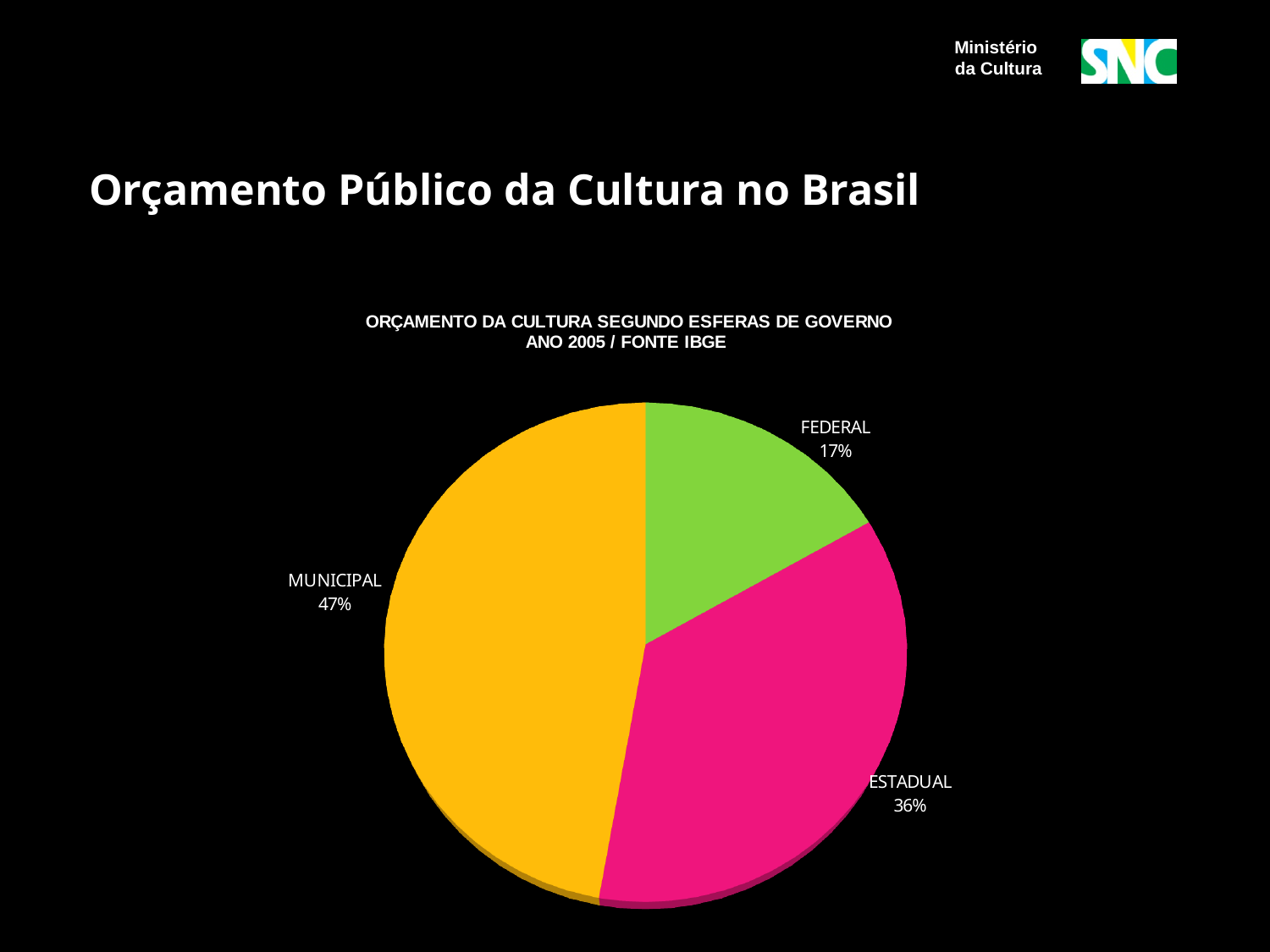
How many categories are shown in the pie chart? 3 What is the difference in percentage points between MUNICIPAL and ESTADUAL? 11 Which category has the largest slice of the pie? MUNICIPAL What share of the pie does ESTADUAL represent? 36% What colour is the MUNICIPAL slice? Yellow What share of the pie does FEDERAL represent? 17% What share of the pie does MUNICIPAL represent? 47% What is the title of the chart? ORÇAMENTO DA CULTURA SEGUNDO ESFERAS DE GOVERNO ANO 2005 / FONTE IBGE What is the difference in percentage points between ESTADUAL and FEDERAL? 19 Which is larger, the ESTADUAL share or the FEDERAL share? ESTADUAL What kind of chart is shown on the slide? Pie chart Which category has the smallest slice of the pie? FEDERAL